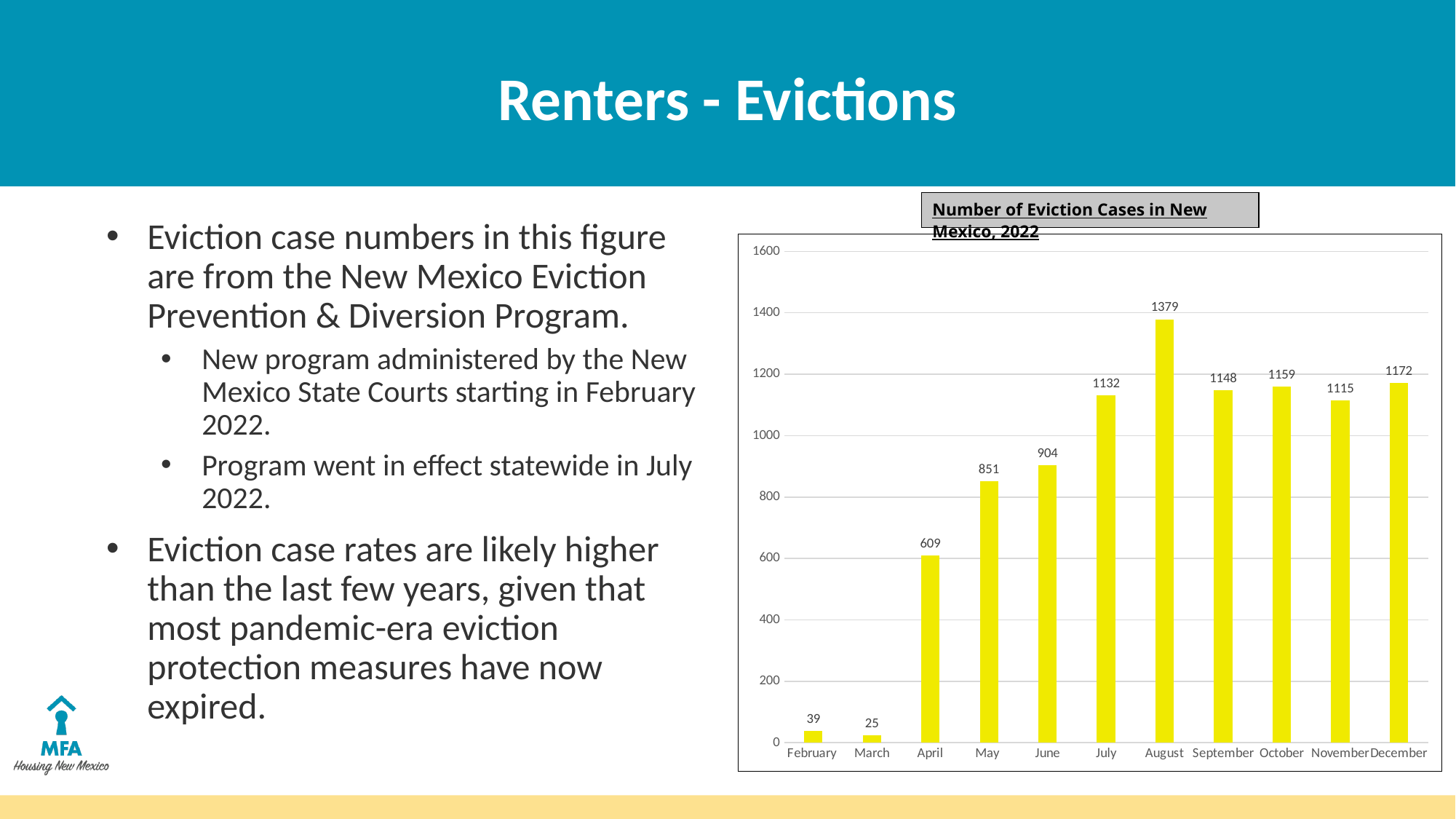
What type of chart is shown on the slide? Bar chart What is the difference between the number of eviction cases in June and May? 53 What is the title of the chart? Number of Eviction Cases in New Mexico, 2022 Is the number of eviction cases in May greater or less than 800? greater How many months are shown on the chart? 11 What is the number of eviction cases in November? 1115 What is the difference between the number of eviction cases in August and July? 247 What is the number of eviction cases in April? 609 Which month has more eviction cases, October or September? October What is the number of eviction cases in August? 1379 Which month has the highest number of eviction cases? August Which month has the lowest number of eviction cases? March